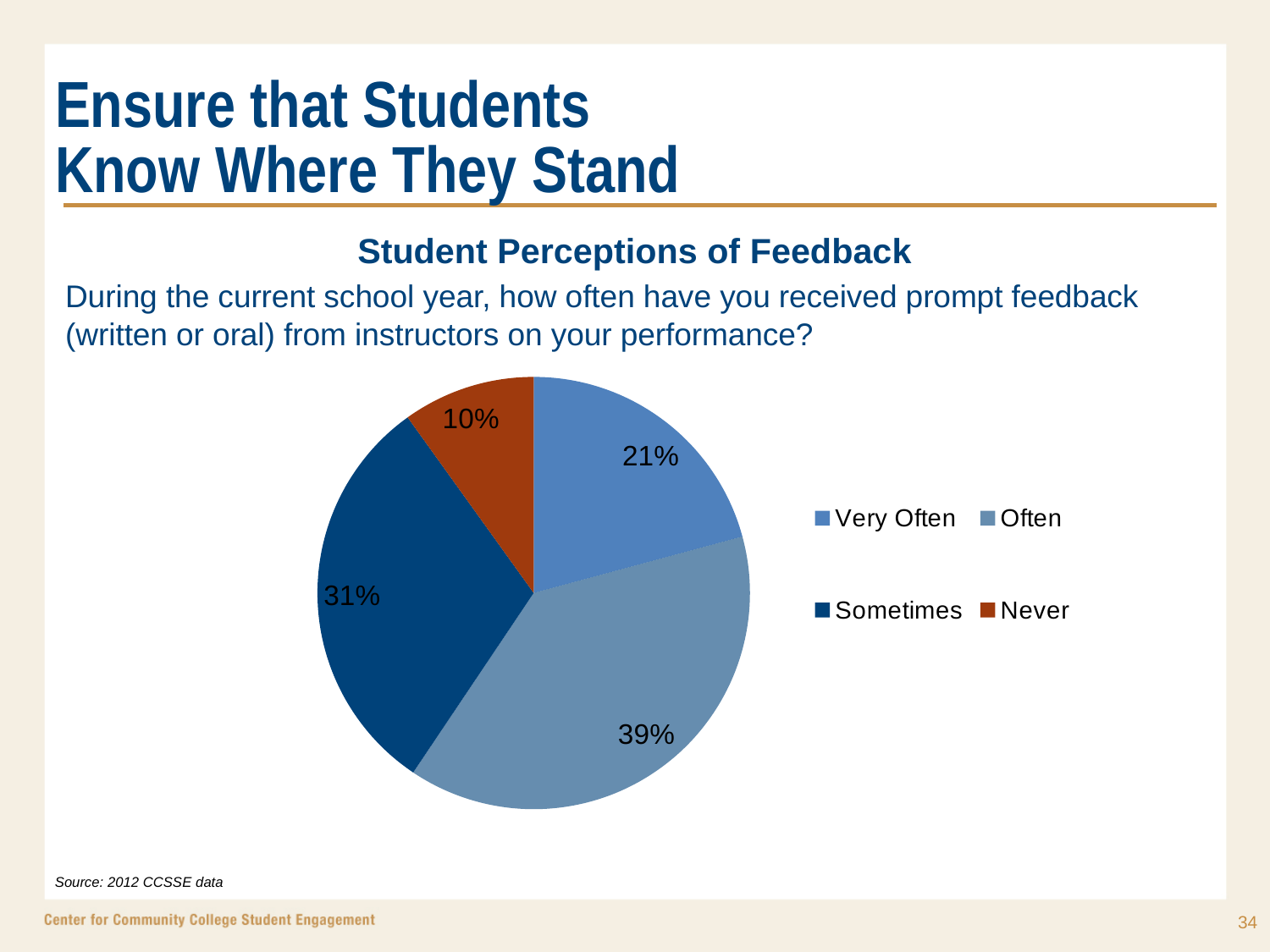
What is the title of the chart? Student Perceptions of Feedback Which response category has the smallest share of the pie? Never How many response categories does the pie chart show? 4 What percentage of students answered "Very Often"? 21% Which is larger, the share for "Very Often" or the share for "Sometimes"? Sometimes What colour is the "Never" slice in the pie chart? orange-brown What is the difference in percentage points between "Often" and "Sometimes"? 8 What kind of chart is shown on the slide? pie chart Which response category has the largest share of the pie? Often What percentage of students answered "Never"? 10% What percentage of students answered "Often"? 39% What percentage of students answered "Sometimes"? 31%